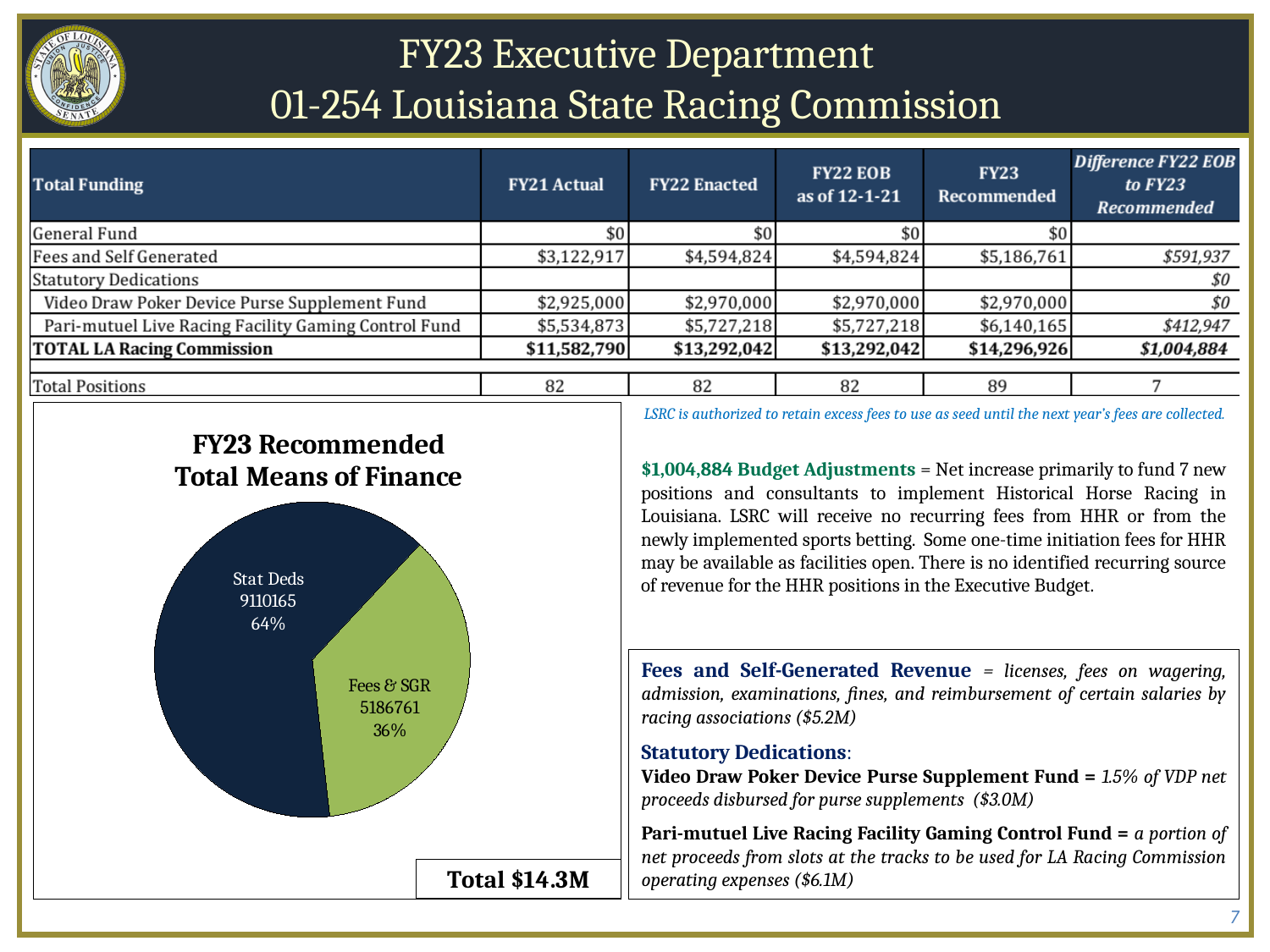
What value is shown for Stat Deds in the pie chart? 9110165 What is the difference between the Stat Deds value and the Fees & SGR value in the pie chart? 3923404 Which is larger in the pie chart, Stat Deds or Fees & SGR? Stat Deds What share of the pie does Stat Deds represent? 64% What is the title of the chart? FY23 Recommended Total Means of Finance What value is shown for Fees & SGR in the pie chart? 5186761 What kind of chart is shown on the slide? pie chart Which slice of the pie chart is the largest? Stat Deds How many slices does the pie chart have? 2 Which slice of the pie chart is the smallest? Fees & SGR What total is shown beneath the pie chart? Total $14.3M What share of the pie does Fees & SGR represent? 36%